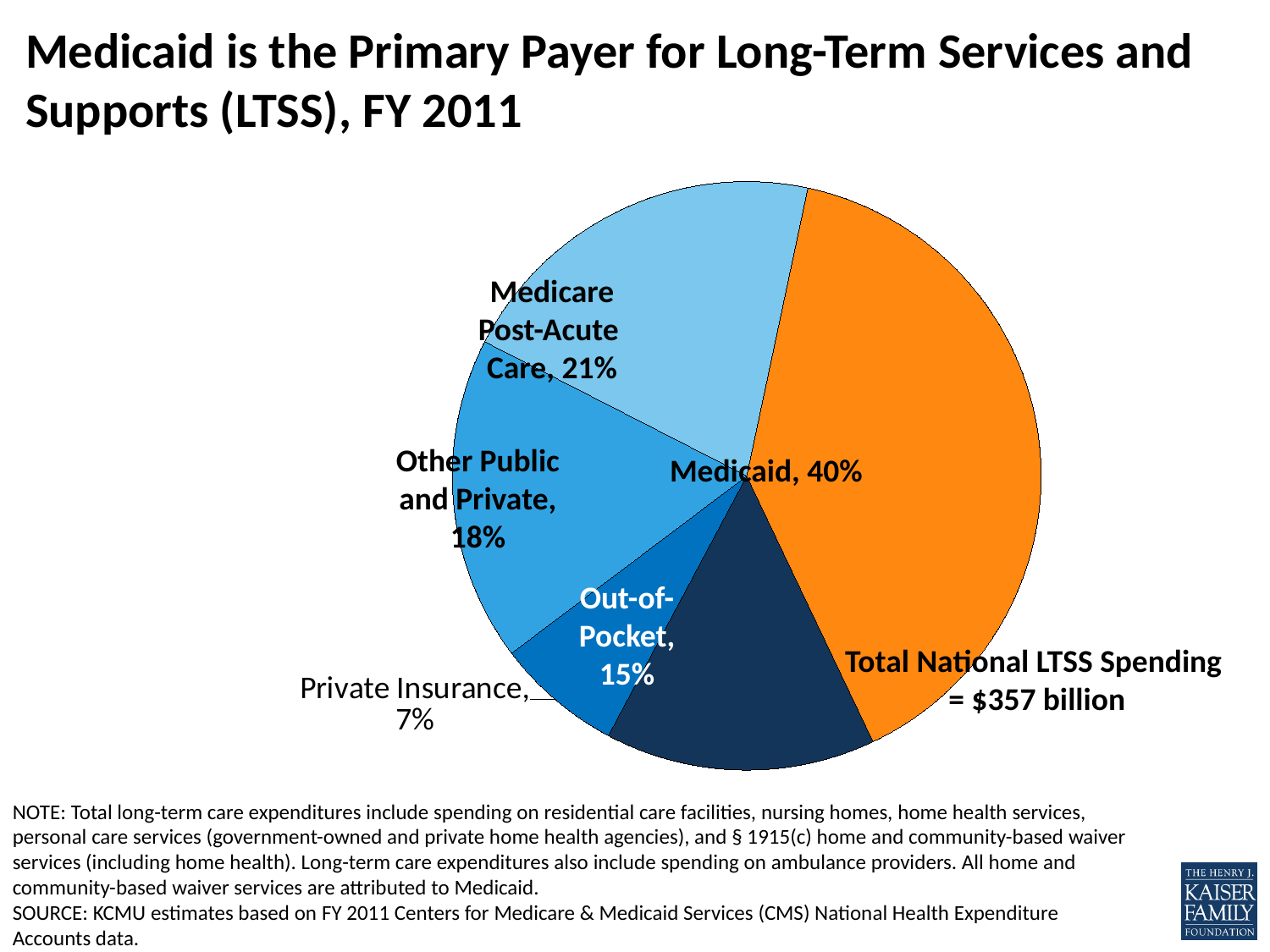
What type of chart is shown on the slide? Pie chart What percentage of LTSS spending is paid by Private Insurance? 7% How many percentage points larger is Medicaid's share than Medicare Post-Acute Care's share? 19 How many payer categories are shown in the pie chart? 5 What is the total national LTSS spending stated on the slide? $357 billion What share of LTSS spending comes from Out-of-Pocket payments? 15% Which is larger: the share for Other Public and Private or the share for Out-of-Pocket? Other Public and Private Which payer has the smallest share of LTSS spending? Private Insurance What percentage of LTSS spending is attributed to Medicare Post-Acute Care? 21% What share of national LTSS spending does Medicaid account for? 40% What is the difference in percentage points between Other Public and Private and Private Insurance? 11 Which payer has the largest share of LTSS spending? Medicaid